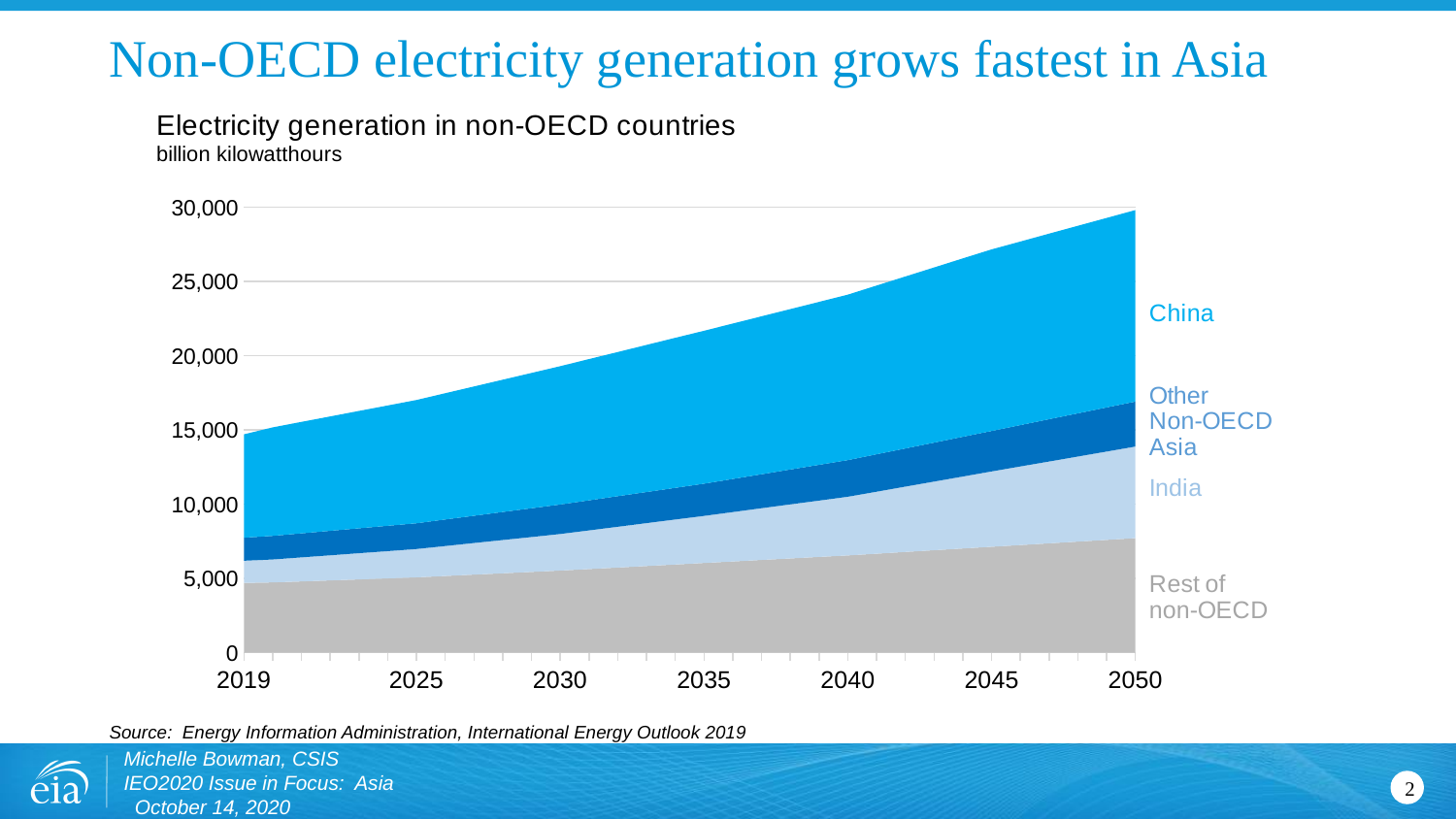
Is total non-OECD electricity generation in 2050 greater or less than 25,000 billion kilowatthours? greater What kind of chart is shown on the slide? Stacked area chart Which region is the largest contributor to non-OECD electricity generation in 2050? China What unit is used for the values in the chart? billion kilowatthours Is total non-OECD electricity generation in 2019 greater or less than 20,000 billion kilowatthours? less What is the title of the chart? Electricity generation in non-OECD countries Which region is the smallest contributor to non-OECD electricity generation in 2050? Other Non-OECD Asia Is total non-OECD electricity generation in 2040 greater or less than 20,000 billion kilowatthours? greater Which is larger in 2050: China's electricity generation or India's? China How many series (regions) are shown in the chart? 4 Does total non-OECD electricity generation rise or fall from 2019 to 2050? Rise